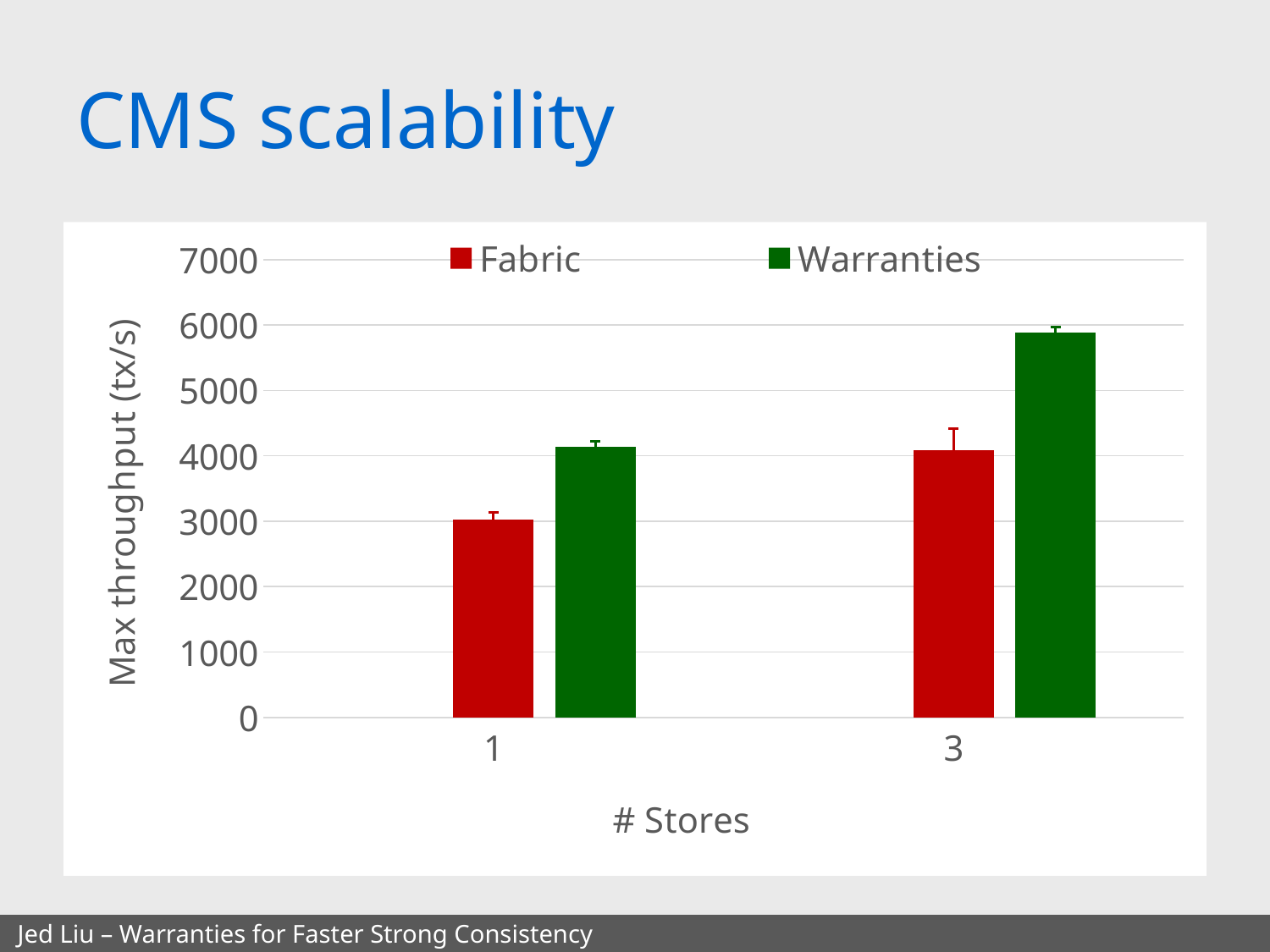
How many categories are shown on the x axis? 2 At 3 stores, which series has the higher max throughput, Fabric or Warranties? Warranties Which series and store count has the highest max throughput? Warranties at 3 stores What kind of chart is shown on the slide? bar chart What is the label of the y axis? Max throughput (tx/s) At 1 store, which series has the higher max throughput, Fabric or Warranties? Warranties Which colour represents the Warranties series in the legend? green Does the max throughput for Fabric rise or fall as the number of stores increases from 1 to 3? rise Is the max throughput for Warranties at 3 stores greater or less than 5000? greater Is the max throughput for Fabric at 1 store greater or less than 4000? less How many series does the legend list? 2 Which series and store count has the lowest max throughput? Fabric at 1 store